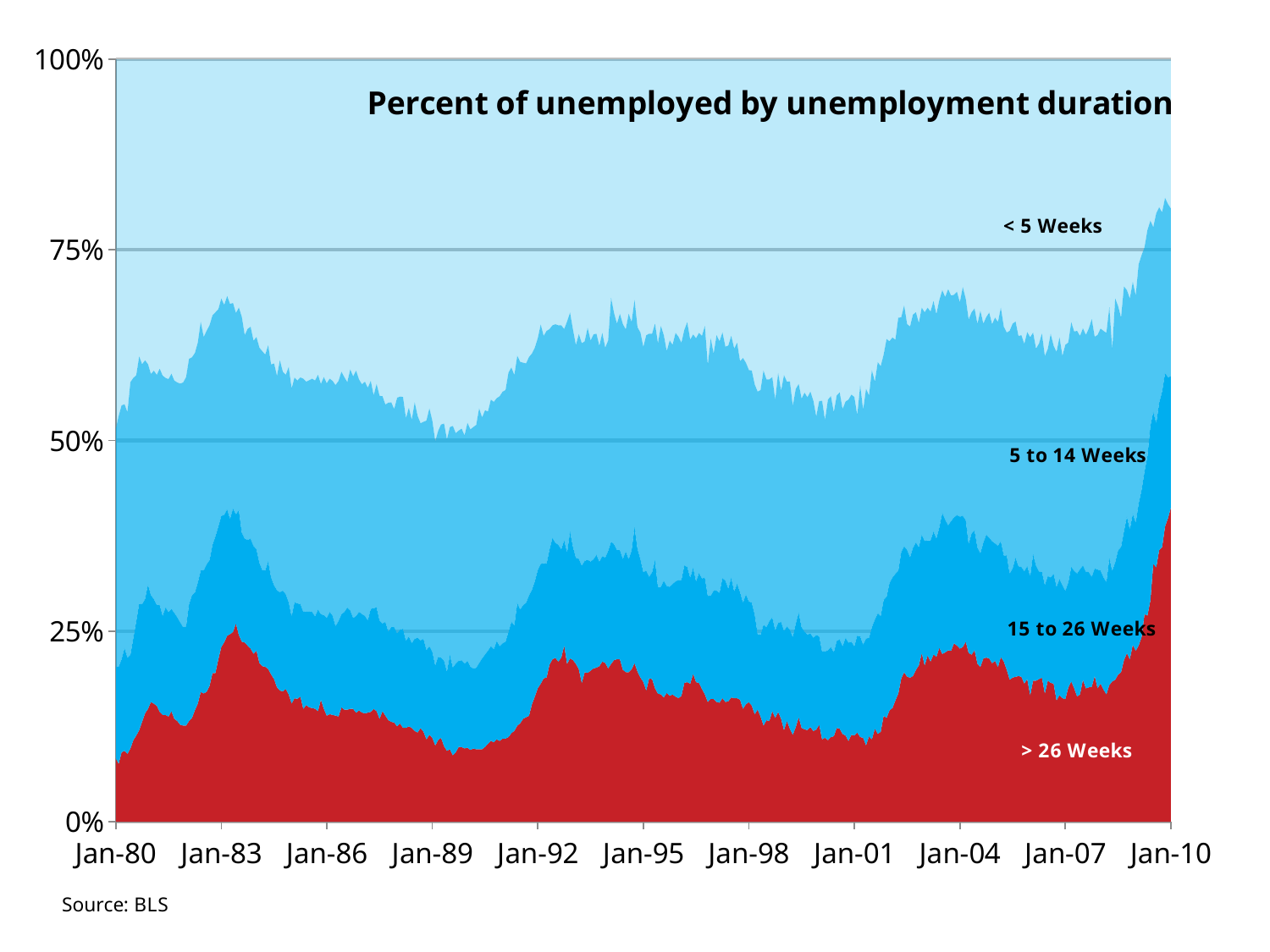
Which duration series has the largest share at Jan-10? > 26 Weeks Is the share for > 26 Weeks at Jan-89 greater or less than 25%? less Does the share for > 26 Weeks rise or fall between Jan-07 and Jan-10? rise How many unemployment duration series are plotted in the chart? 4 Which series is drawn in red at the bottom of the stack? > 26 Weeks What is the title of the chart? Percent of unemployed by unemployment duration How many date labels are shown on the x axis? 11 Which duration series has the largest share at Jan-80? < 5 Weeks Is the share for > 26 Weeks at Jan-83 greater or less than 50%? less Does the share for > 26 Weeks rise or fall between Jan-83 and Jan-89? fall What kind of chart is shown on the slide? Stacked area chart Is the share for > 26 Weeks at Jan-10 greater or less than 25%? greater